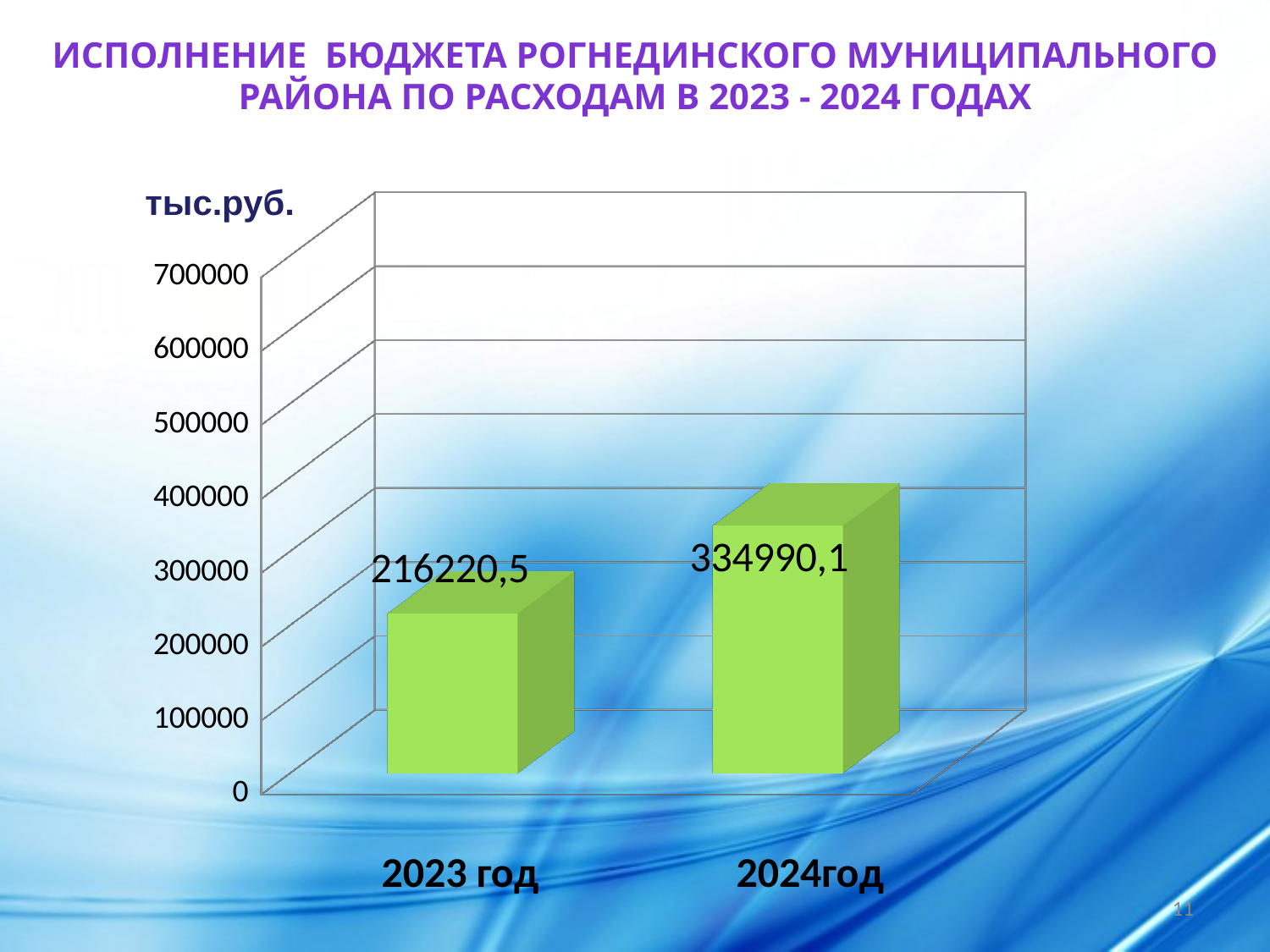
Do the values rise or fall from 2023 год to 2024год? rise What kind of chart is shown on the slide? bar chart Which year has the highest value? 2024год Is the value for 2023 год greater or less than 300000? less Which is larger, the value for 2023 год or the value for 2024год? 2024год What is the value for 2023 год? 216220,5 What is the value for 2024год? 334990,1 Which year has the lowest value? 2023 год Is the value for 2024год greater or less than 300000? greater What is the difference between the values for 2024год and 2023 год? 118769,6 What unit is shown above the vertical axis of the chart? тыс.руб. How many bars are shown in the chart? 2